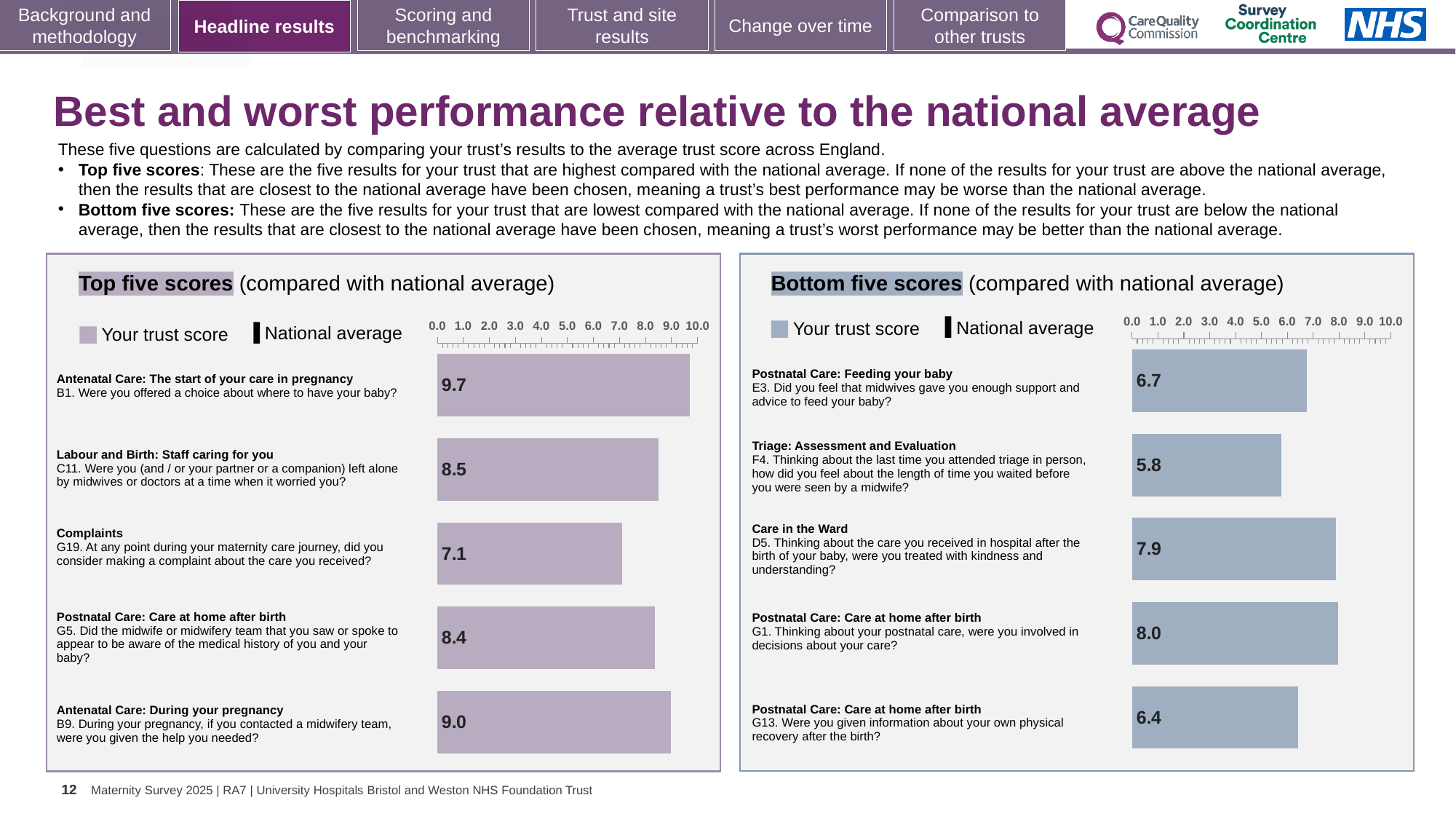
In the Bottom five scores chart, what is the difference between the scores for G1 and E3? 1.3 In the Bottom five scores chart, what is the trust score for F4 (Triage: Assessment and Evaluation)? 5.8 In the Top five scores chart, which question has the lowest trust score? G19 (Complaints) In the Bottom five scores chart, which question has the lowest trust score? F4 (Triage: Assessment and Evaluation) How many entries does the legend of the Top five scores chart list? 2 In the Top five scores chart, what is the difference between the scores for B1 and G19? 2.6 In the Top five scores chart, what is the trust score for B1 (Were you offered a choice about where to have your baby?)? 9.7 In the Bottom five scores chart, which question has the highest trust score? G1 (Postnatal Care: Care at home after birth) In the Bottom five scores chart, which has the larger trust score: D5 or G13? D5 What type of chart is used in the Bottom five scores panel? Bar chart How many bars are shown in the Top five scores chart? 5 In the Top five scores chart, which question has the highest trust score? B1 (Antenatal Care: The start of your care in pregnancy)